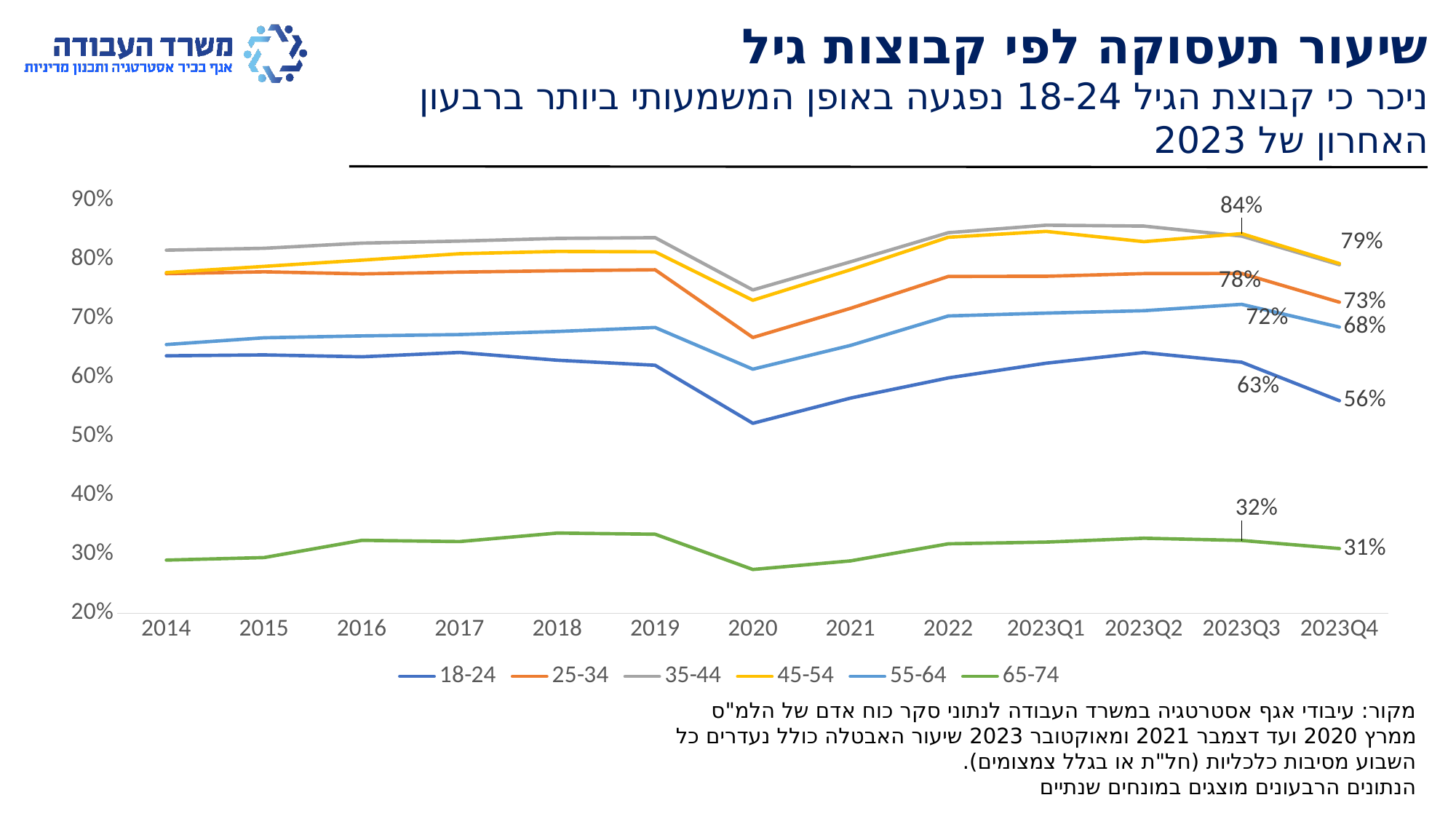
What type of chart is shown on the slide? Line chart At 2023Q4, which is larger: the 25-34 series or the 55-64 series? 25-34 How many series does the legend list? 6 Does the 18-24 series rise or fall from 2023Q2 to 2023Q4? Fall What is the value for the 65-74 series at 2023Q3? 32% What is the value for the 25-34 series at 2023Q3? 78% What is the value for the 18-24 series at 2023Q4? 56% Which series has the lowest value at 2023Q4? 65-74 By how many percentage points did the 18-24 series fall from 2023Q3 (63%) to 2023Q4 (56%)? 7 percentage points What is the value for the 55-64 series at 2023Q4? 68% How many points are there along the x axis? 13 Is the value for the 18-24 series in 2020 greater or less than 60%? less